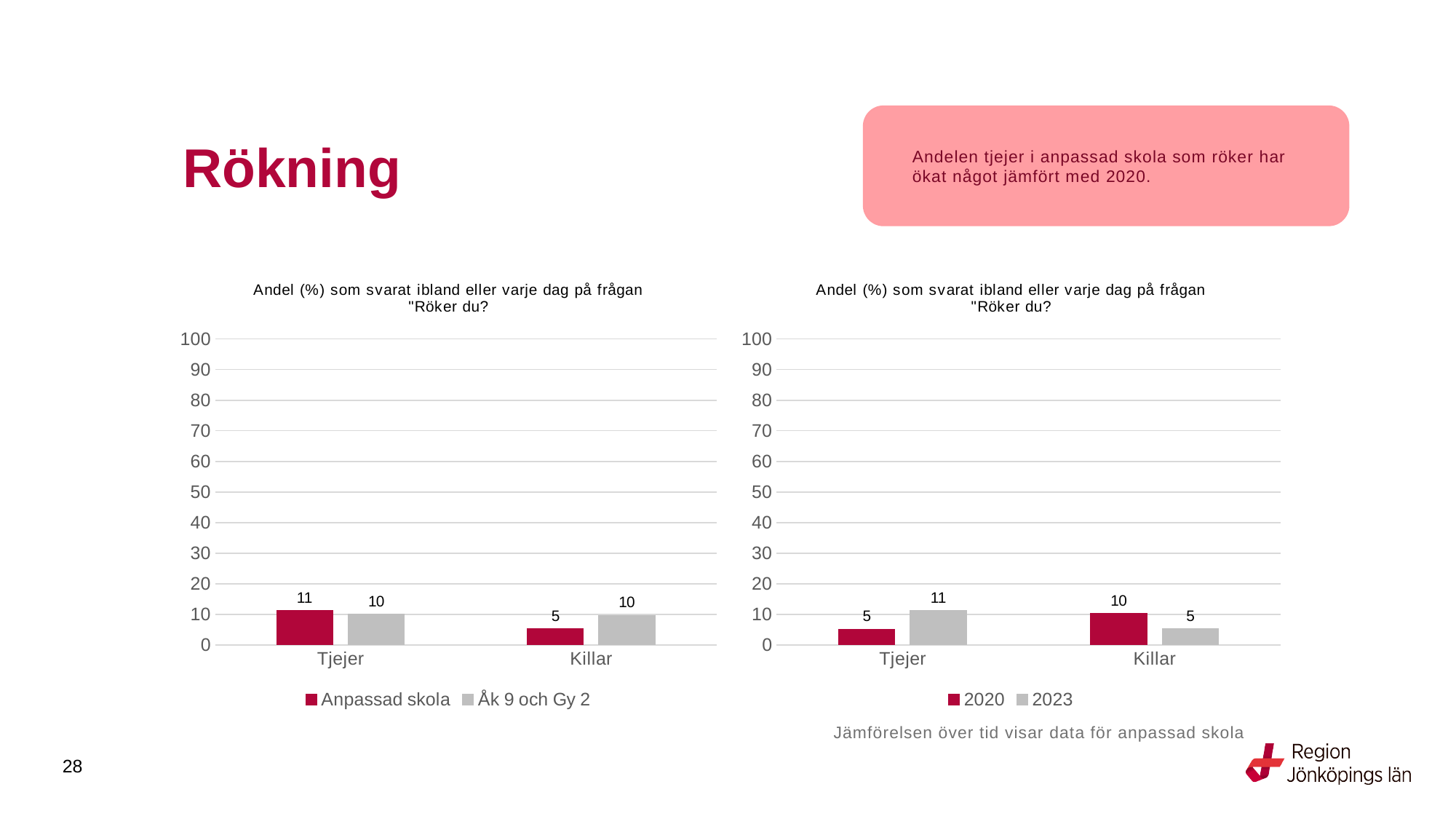
In the left chart, which category has the lower value in the Anpassad skola series? Killar What kind of chart is the right chart? Bar chart In the right chart, what is the value for Tjejer in 2023? 11 In the left chart, how many series does the legend list? 2 In the left chart, what is the value for Tjejer in the Anpassad skola series? 11 In the right chart, what is the difference between the 2023 and 2020 values for Tjejer? 6 How many categories are shown on the x axis of the left chart? 2 In the right chart, what is the value for Killar in 2020? 10 In the left chart, what is the value for Killar in the Åk 9 och Gy 2 series? 10 In the left chart, what is the difference between the Anpassad skola and Åk 9 och Gy 2 values for Killar? 5 In the right chart, is the value for Killar in 2020 greater or less than 20? less In the right chart, which is larger for Tjejer: the 2020 value or the 2023 value? 2023